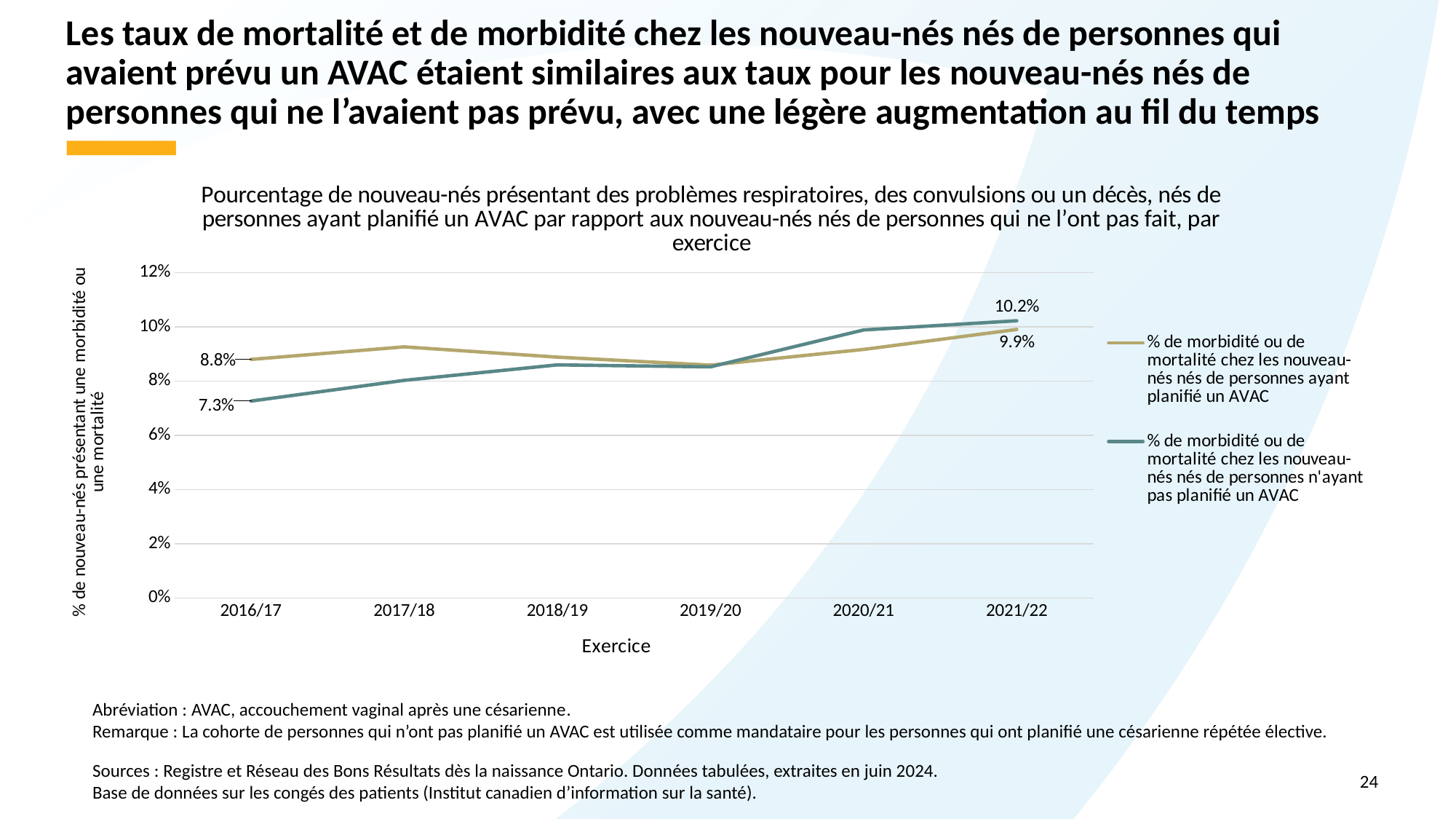
How many series does the legend list? 2 What is the value in 2021/22 for newborns of people who planned a VBAC (AVAC)? 9.9% What is the difference between the 2016/17 values for the planned-VBAC series (8.8%) and the not-planned series (7.3%)? 1.5% Overall, does the not-planned VBAC series rise or fall from 2016/17 to 2021/22? Rise What kind of chart is shown on the slide? Line chart By how much did the value for newborns of people who did not plan a VBAC increase from 2016/17 to 2021/22? 2.9% In 2016/17, which series has the higher value: planned VBAC or not planned VBAC? Planned VBAC Is the value for the not-planned VBAC series in 2020/21 greater or less than 8%? greater What is the value in 2021/22 for newborns of people who did not plan a VBAC (AVAC)? 10.2% How many fiscal years (exercices) are shown on the x axis? 6 What is the value in 2016/17 for newborns of people who did not plan a VBAC (AVAC)? 7.3% What is the value in 2016/17 for newborns of people who planned a VBAC (AVAC)? 8.8%